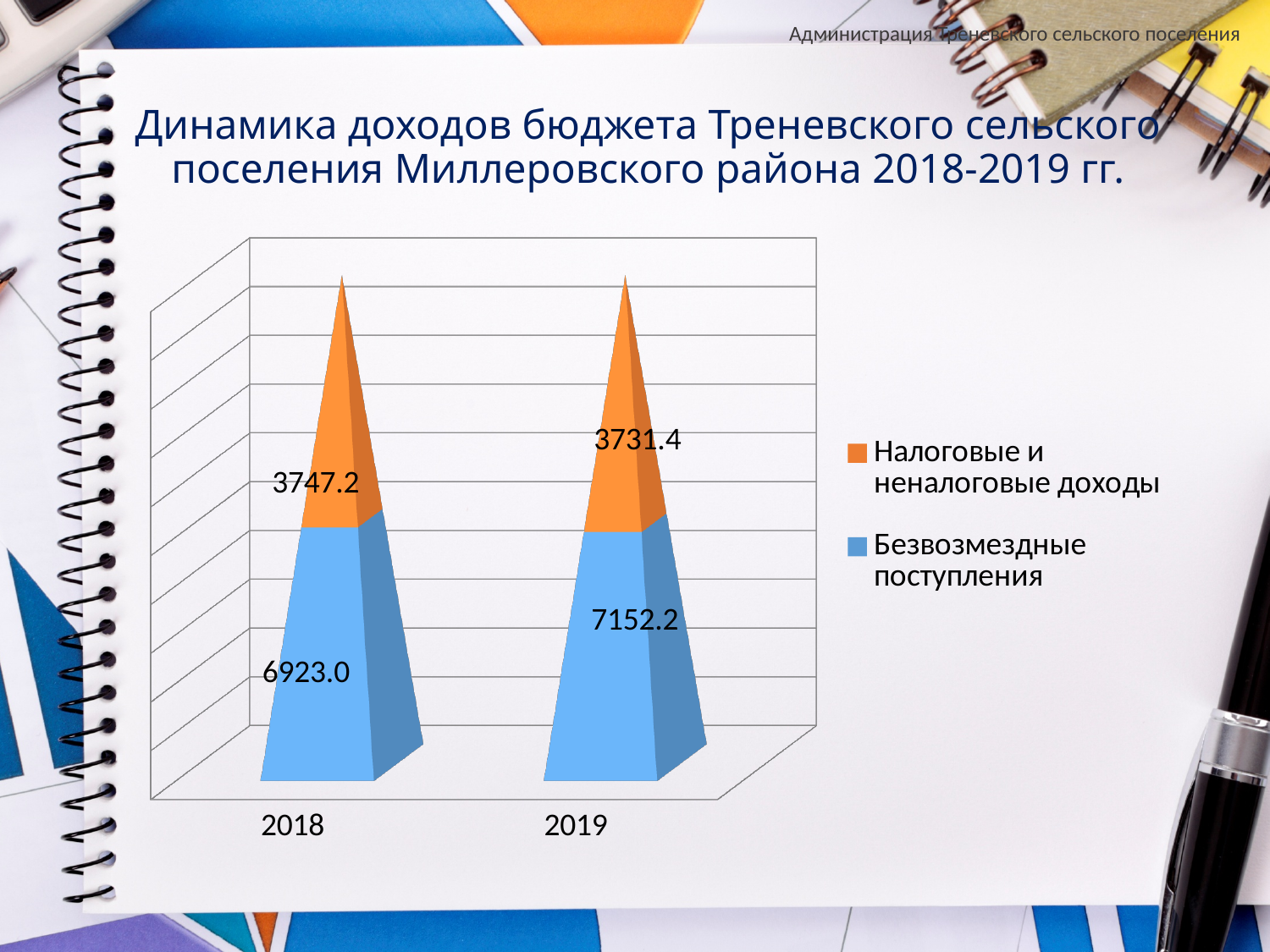
In which year is the value of Безвозмездные поступления higher? 2019 What is the total of the stacked bar for 2018? 10670.2 By how much did Безвозмездные поступления change from 2018 to 2019? 229.2 What kind of chart is shown on the slide? Stacked bar chart What is the value of Безвозмездные поступления for 2019? 7152.2 How many series does the legend list? 2 What is the value of Налоговые и неналоговые доходы for 2019? 3731.4 What is the value of Безвозмездные поступления for 2018? 6923.0 In which year is the value of Налоговые и неналоговые доходы higher? 2018 What is the value of Налоговые и неналоговые доходы for 2018? 3747.2 What is the total of the stacked bar for 2019? 10883.6 What is the difference between Налоговые и неналоговые доходы in 2018 and 2019? 15.8